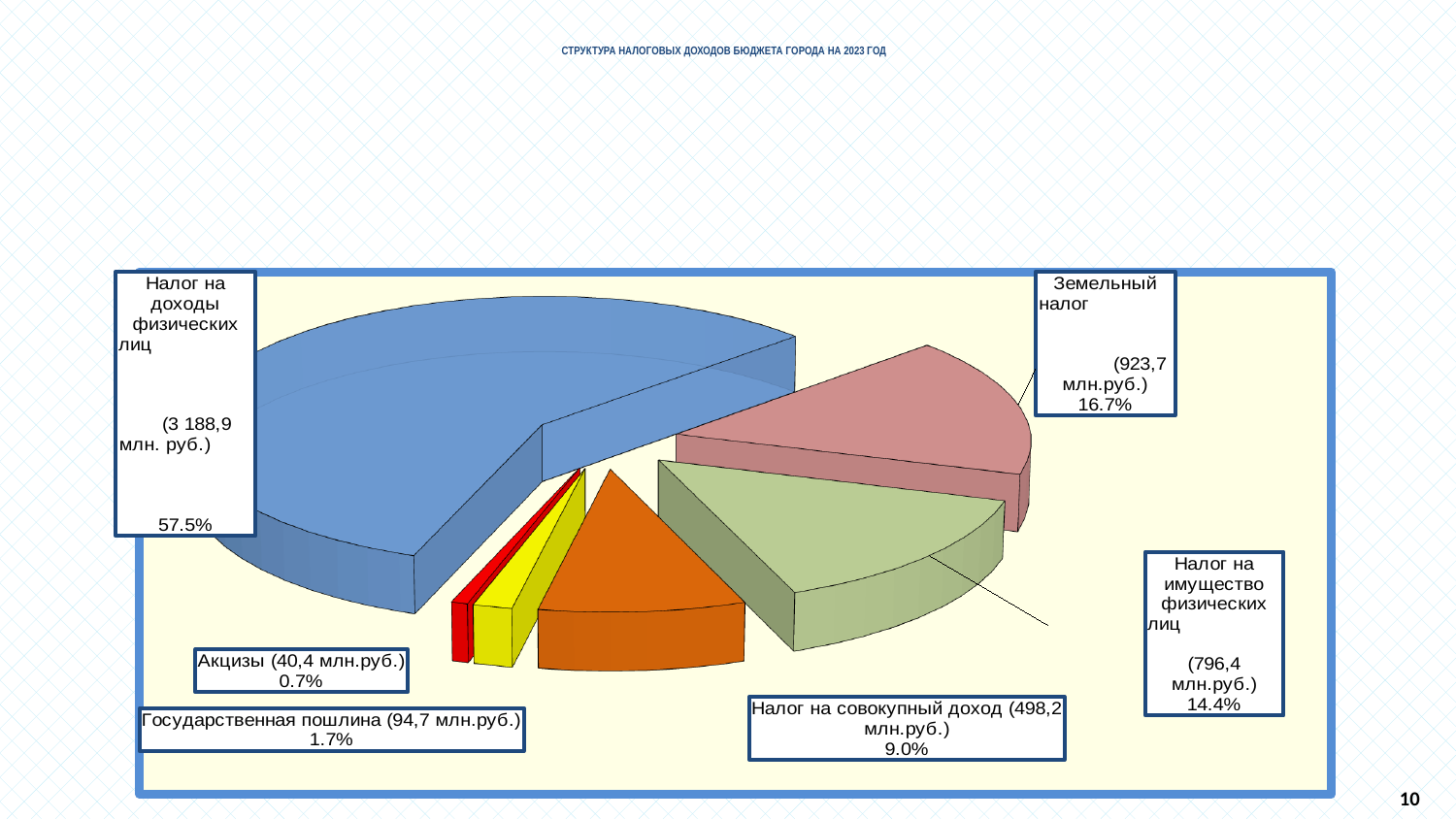
What kind of chart is shown on the slide? pie chart What is the difference in percentage points between "Государственная пошлина" (1.7%) and "Акцизы" (0.7%)? 1.0% Which category has the largest share of the pie? Налог на доходы физических лиц What is the value shown for "Налог на совокупный доход" in млн.руб.? 498,2 Which is larger: the share for "Земельный налог" or for "Налог на имущество физических лиц"? Земельный налог What percentage is shown for "Акцизы"? 0.7% Which category has the smallest share of the pie? Акцизы What is the title of the chart on the slide? СТРУКТУРА НАЛОГОВЫХ ДОХОДОВ БЮДЖЕТА ГОРОДА НА 2023 ГОД How many slices does the pie chart have? 6 What percentage is shown for "Налог на имущество физических лиц"? 14.4% What is the value shown for "Земельный налог" in млн.руб.? 923,7 What share of the pie does "Налог на доходы физических лиц" represent? 57.5%